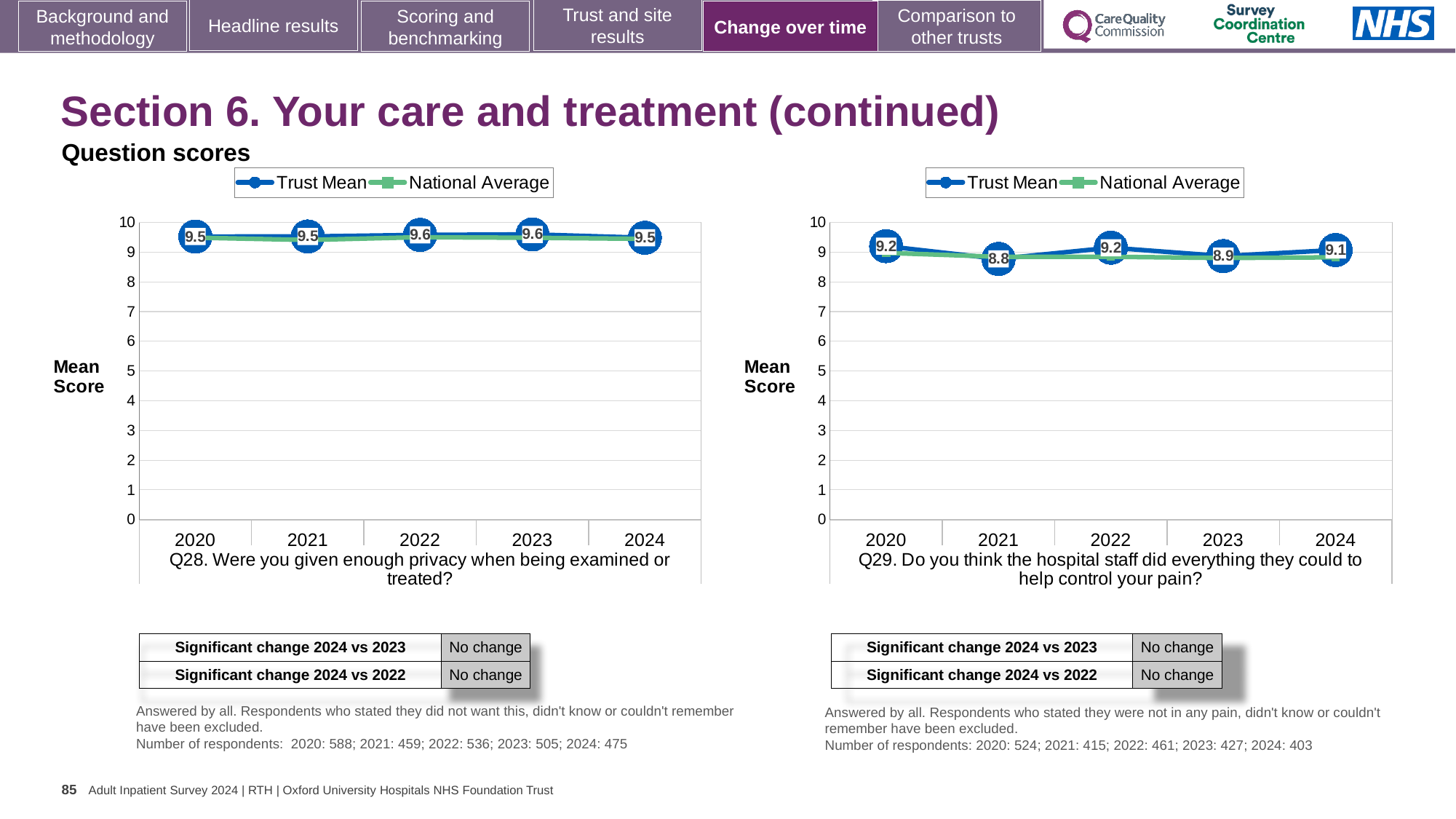
In the Q28 chart on the left, what is the Trust Mean score for 2024? 9.5 How many series does the legend of the Q29 chart on the right list? 2 In the Q29 chart on the right, what is the difference between the Trust Mean scores for 2020 and 2021? 0.4 In the Q29 chart on the right, is the Trust Mean score higher in 2022 or in 2023? 2022 What are the two series named in the legend of the Q28 chart on the left? Trust Mean and National Average In the Q28 chart on the left, what is the Trust Mean score for 2022? 9.6 In the Q29 chart on the right, what is the Trust Mean score for 2021? 8.8 How many years are plotted on the x axis of the Q28 chart on the left? 5 In the Q29 chart on the right, what is the Trust Mean score for 2024? 9.1 In the Q29 chart on the right, which year has the lowest Trust Mean score? 2021 What type of chart is the Q28 chart on the left? Line chart In the Q28 chart on the left, is the National Average value for 2024 greater or less than 9? greater